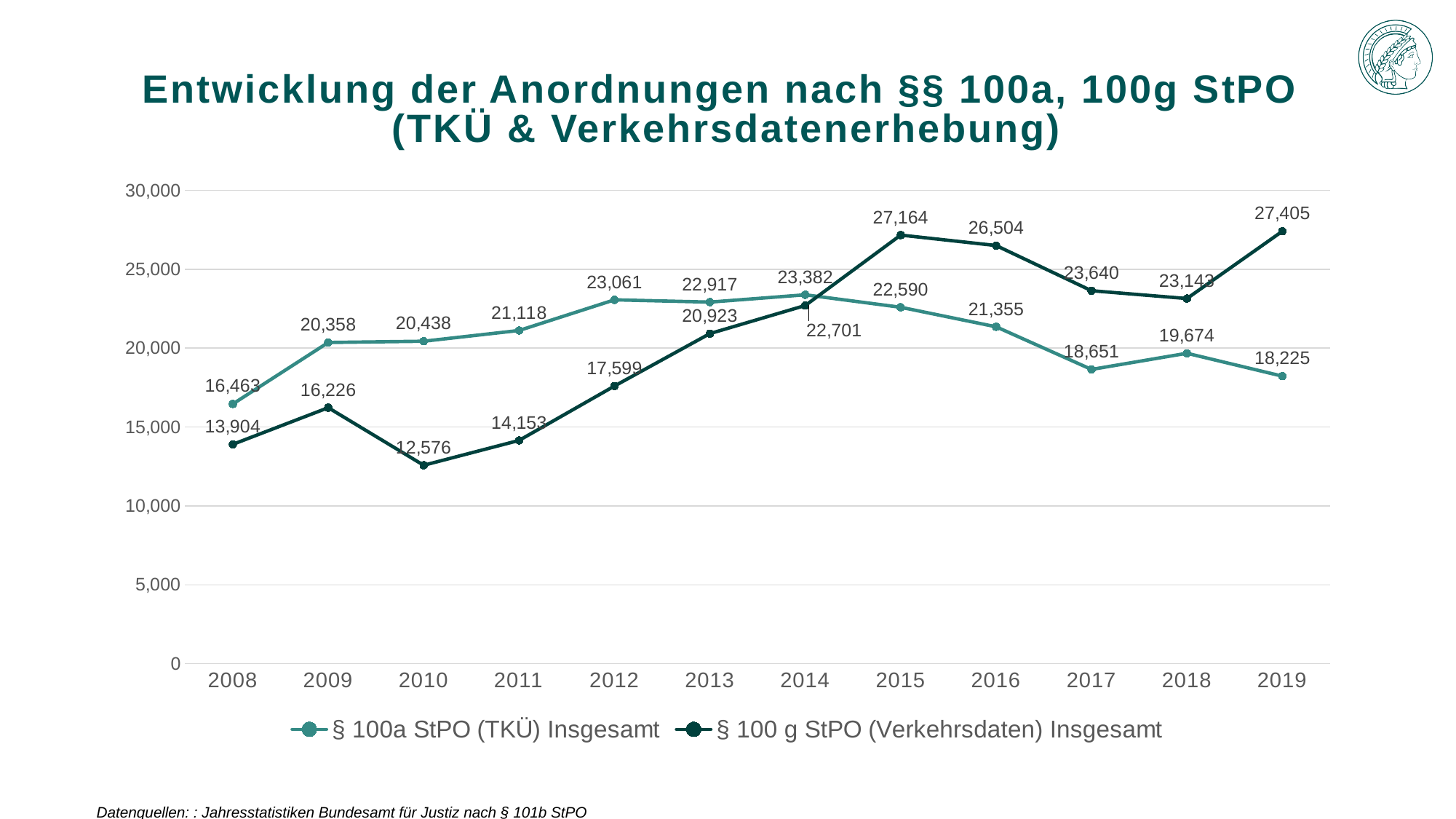
In which year does the § 100 g StPO (Verkehrsdaten) Insgesamt series have its lowest value? 2010 Does the § 100a StPO (TKÜ) Insgesamt series rise or fall from 2014 to 2017? fall Is the value for § 100 g StPO (Verkehrsdaten) Insgesamt in 2015 greater or less than 25,000? greater What is the value for § 100 g StPO (Verkehrsdaten) Insgesamt in 2019? 27,405 Which series has the larger value in 2008, § 100a StPO (TKÜ) Insgesamt or § 100 g StPO (Verkehrsdaten) Insgesamt? § 100a StPO (TKÜ) Insgesamt What is the value for § 100 g StPO (Verkehrsdaten) Insgesamt in 2010? 12,576 What is the difference between the § 100 g StPO (Verkehrsdaten) Insgesamt value and the § 100a StPO (TKÜ) Insgesamt value in 2019? 9,180 What kind of chart is shown on the slide? line chart What is the value for § 100a StPO (TKÜ) Insgesamt in 2012? 23,061 How many series does the legend list? 2 In which year does the § 100a StPO (TKÜ) Insgesamt series reach its highest value? 2014 How many years are shown on the x axis? 12